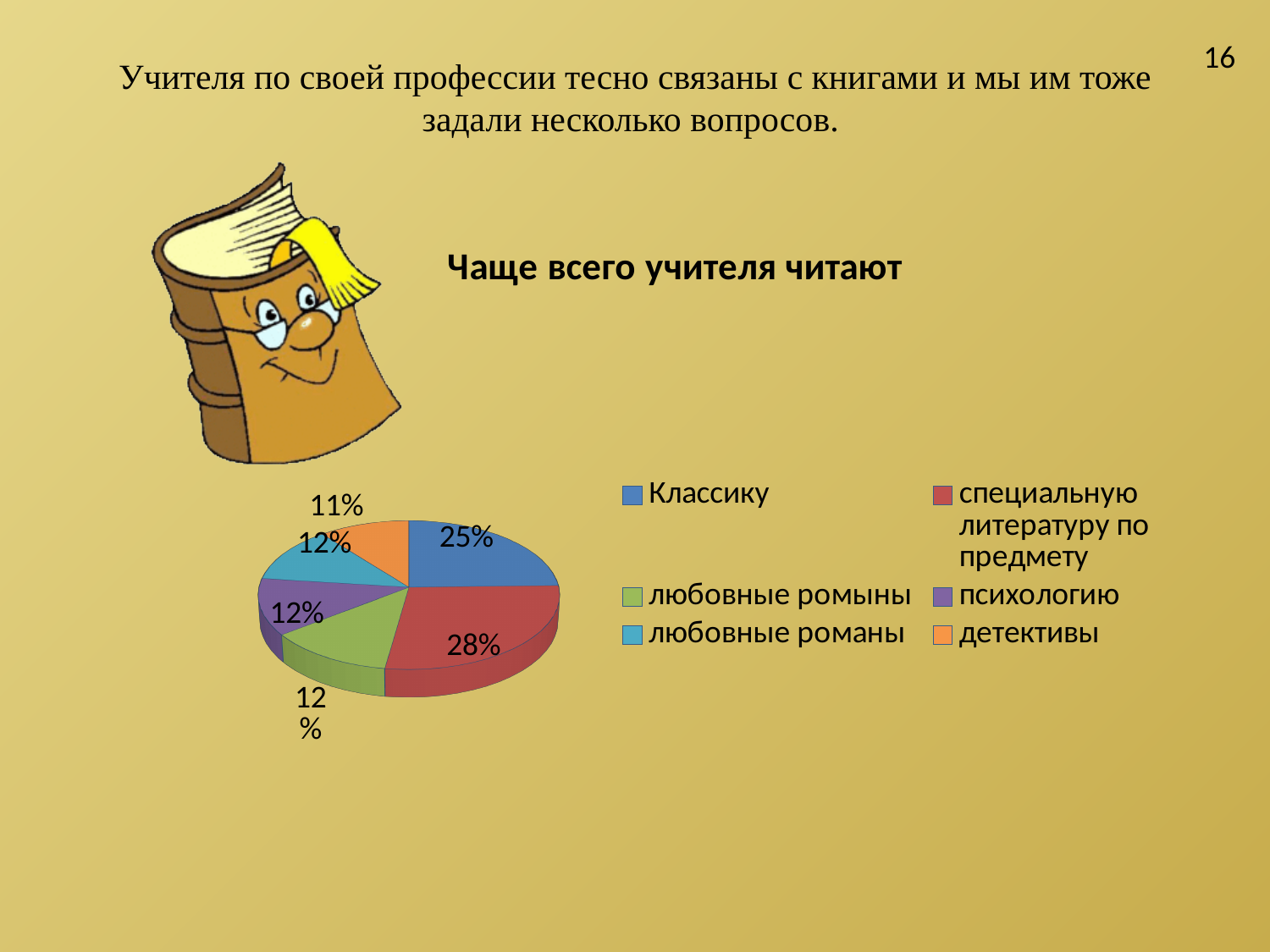
What type of chart is shown on the slide? Pie chart What colour is the slice for Классику? Blue Which category has the largest slice of the pie chart? специальную литературу по предмету Which category has the smallest slice of the pie chart? детективы What percentage of the pie is the slice for детективы? 11% What percentage of the pie chart is the slice for Классику? 25% By how many percentage points does the slice for специальную литературу по предмету exceed the slice for Классику? 3 percentage points What is the title of the chart? Чаще всего учителя читают How many slices does the pie chart have? 6 What percentage of the pie is the slice for психологию? 12% What percentage does the slice for специальную литературу по предмету represent? 28% Which slice is larger: Классику or детективы? Классику